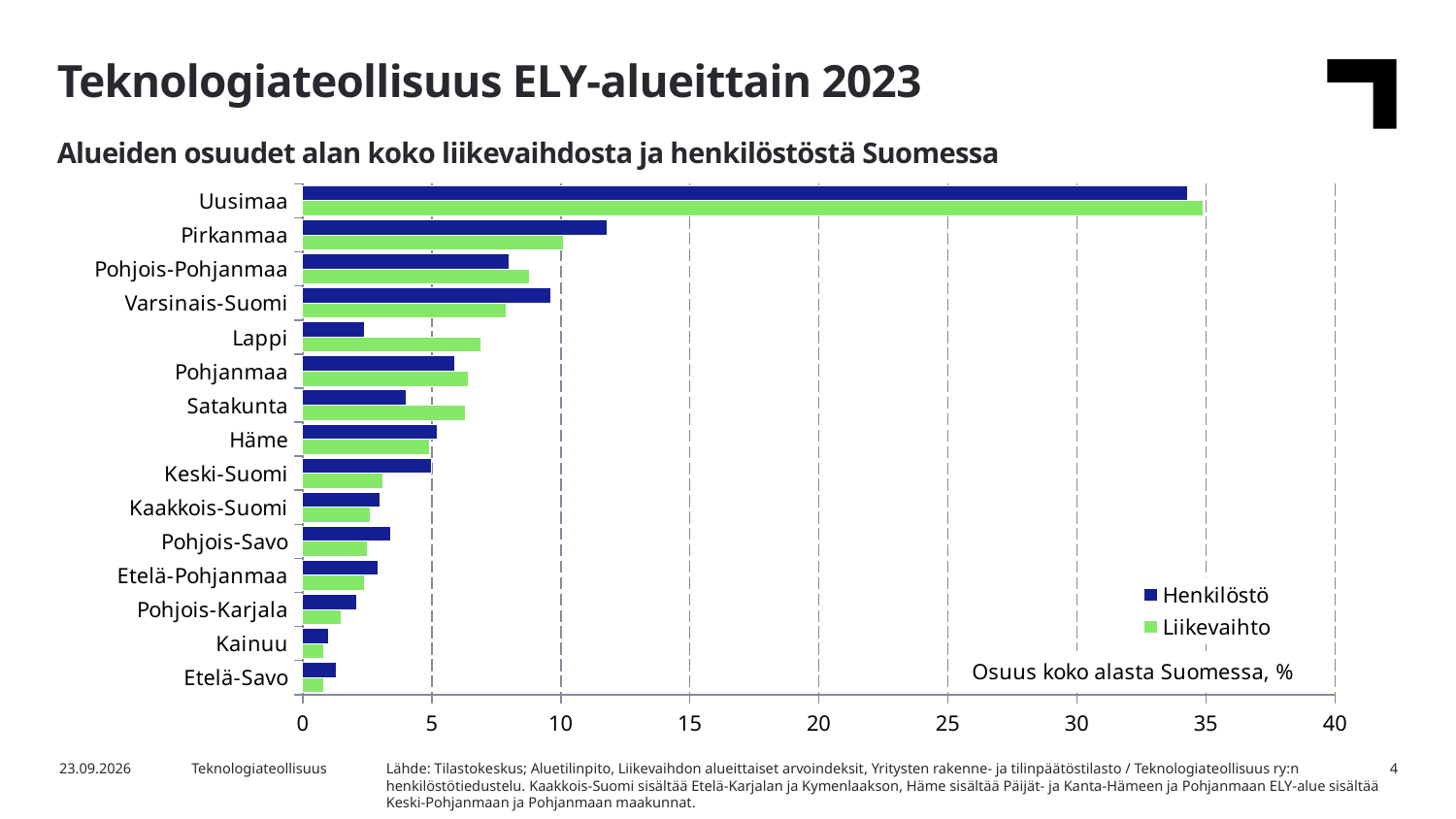
Is the Liikevaihto value for Pohjois-Pohjanmaa greater or less than 10? less What kind of chart is shown on the slide? Bar chart Is the Henkilöstö value for Pirkanmaa greater or less than 10? greater For Lappi, which is larger: the Henkilöstö share or the Liikevaihto share? Liikevaihto For Varsinais-Suomi, which is larger: the Henkilöstö share or the Liikevaihto share? Henkilöstö How many series does the legend list? 2 How many regions (categories) are shown on the chart? 15 Which colour represents the Liikevaihto series in the legend? Green Is the Henkilöstö value for Lappi greater or less than 5? less Which region has the highest Liikevaihto share? Uusimaa Which region has the highest Henkilöstö share? Uusimaa